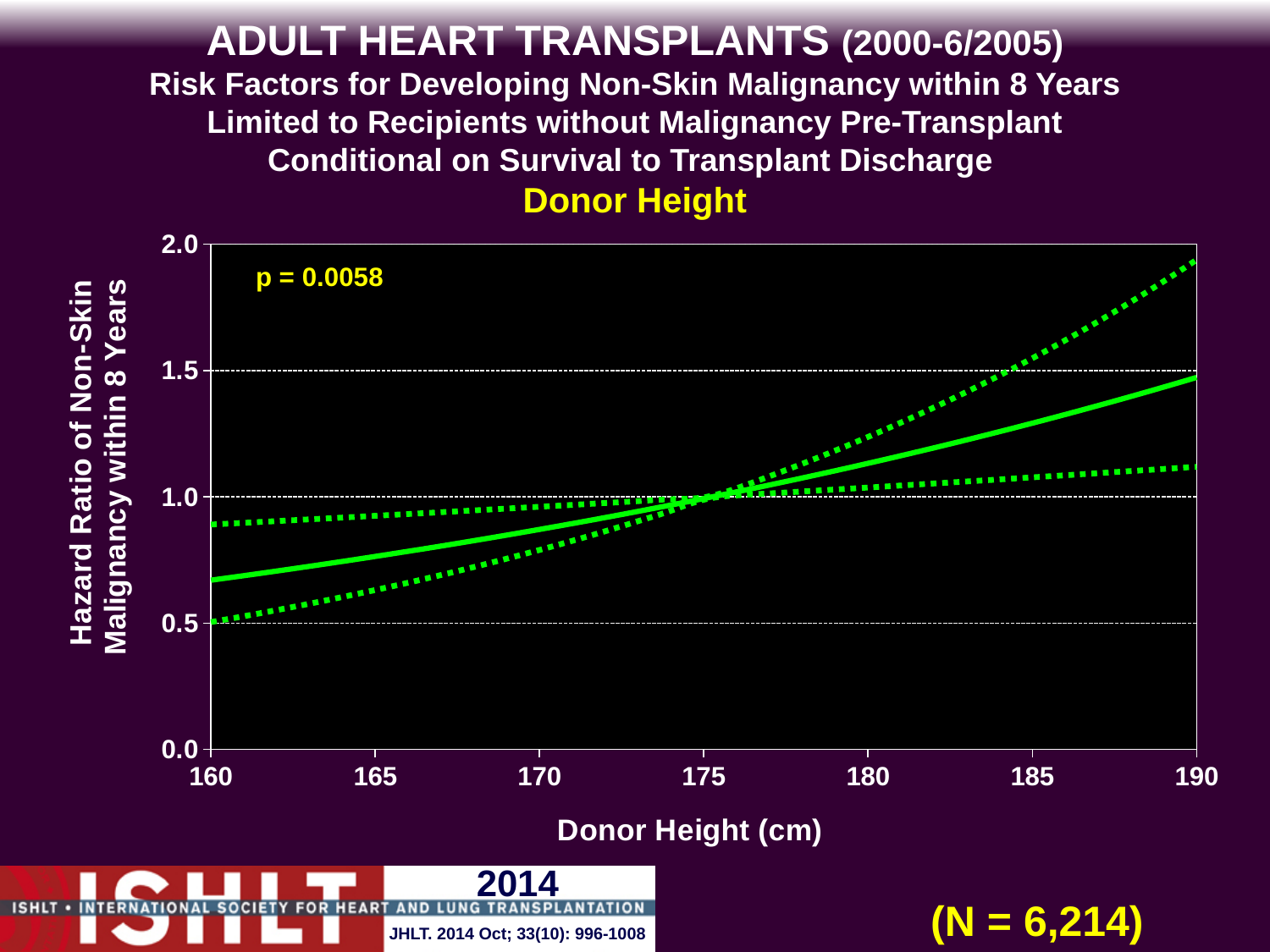
What kind of chart is shown on the slide? line chart What is the highest value shown on the y axis? 2.0 What sample size (N) is printed on the slide? N = 6,214 What is the label of the x axis? Donor Height (cm) Is the solid hazard ratio line at a donor height of 185 cm greater or less than 1.5? less How many lines are plotted on the chart? 3 What p-value is printed on the chart? p = 0.0058 Is the solid hazard ratio line at a donor height of 185 cm greater or less than 1.0? greater Is the upper dotted line at a donor height of 190 cm greater or less than 1.5? greater Does the solid hazard ratio line rise or fall as donor height increases from 160 to 190 cm? rises Is the solid hazard ratio line higher at 190 cm or at 160 cm donor height? 190 cm